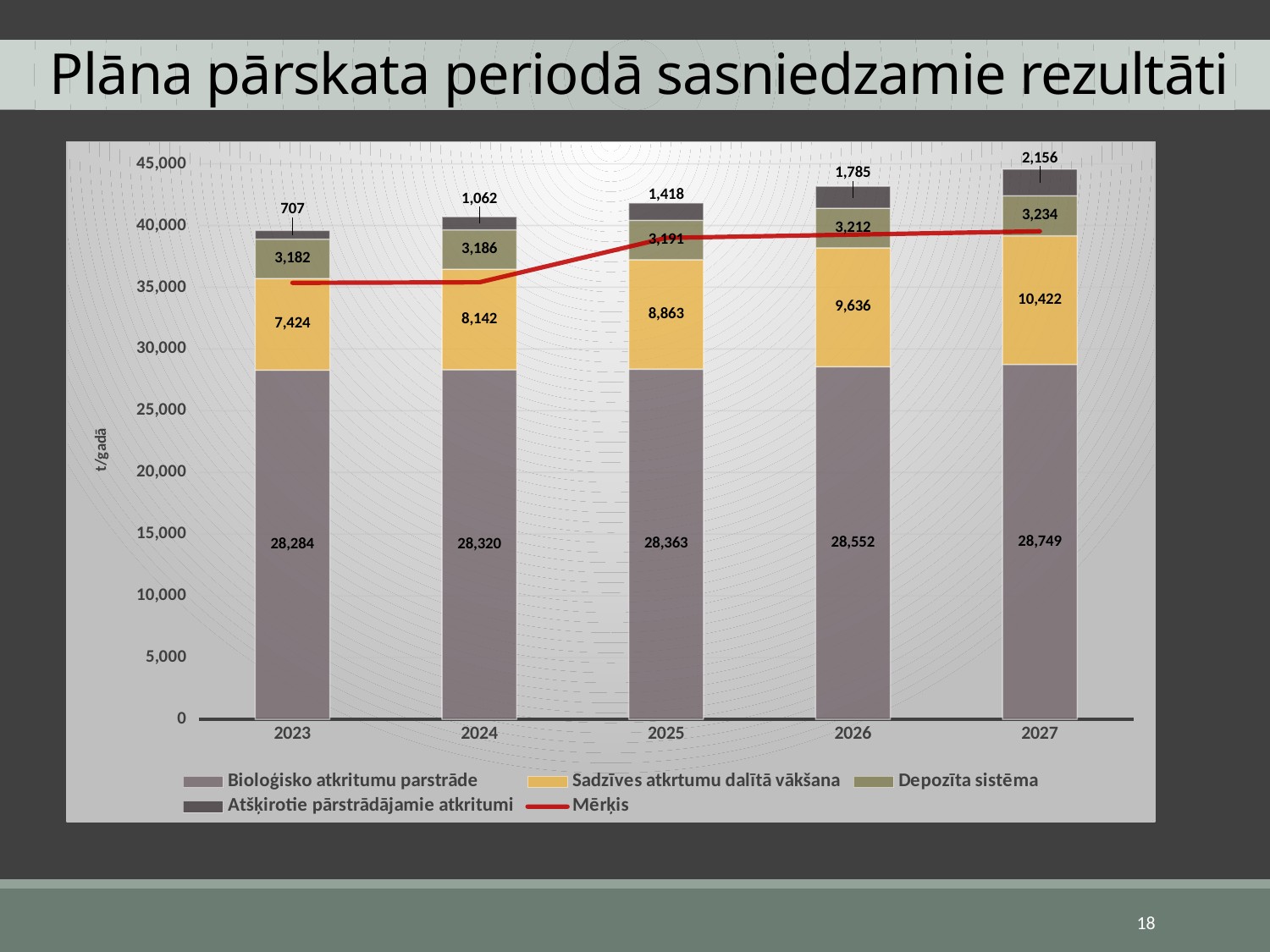
Is the Mērķis line value for 2023 greater or less than 40,000? less What is the value for Sadzīves atkrtumu dalītā vākšana in 2027? 10,422 How many series does the legend list? 5 What is the total of the stacked bar for 2023? 39,597 What is the value for Atšķirotie pārstrādājamie atkritumi in 2023? 707 In which year is the Atšķirotie pārstrādājamie atkritumi value lowest? 2023 How many years are shown on the x axis? 5 What is the value for Bioloģisko atkritumu parstrāde in 2025? 28,363 What is the difference between the Sadzīves atkrtumu dalītā vākšana values for 2027 and 2023? 2,998 In which year is the Sadzīves atkrtumu dalītā vākšana value highest? 2027 Which is larger: Bioloģisko atkritumu parstrāde in 2024 or in 2026? 2026 What is the value for Depozīta sistēma in 2026? 3,212